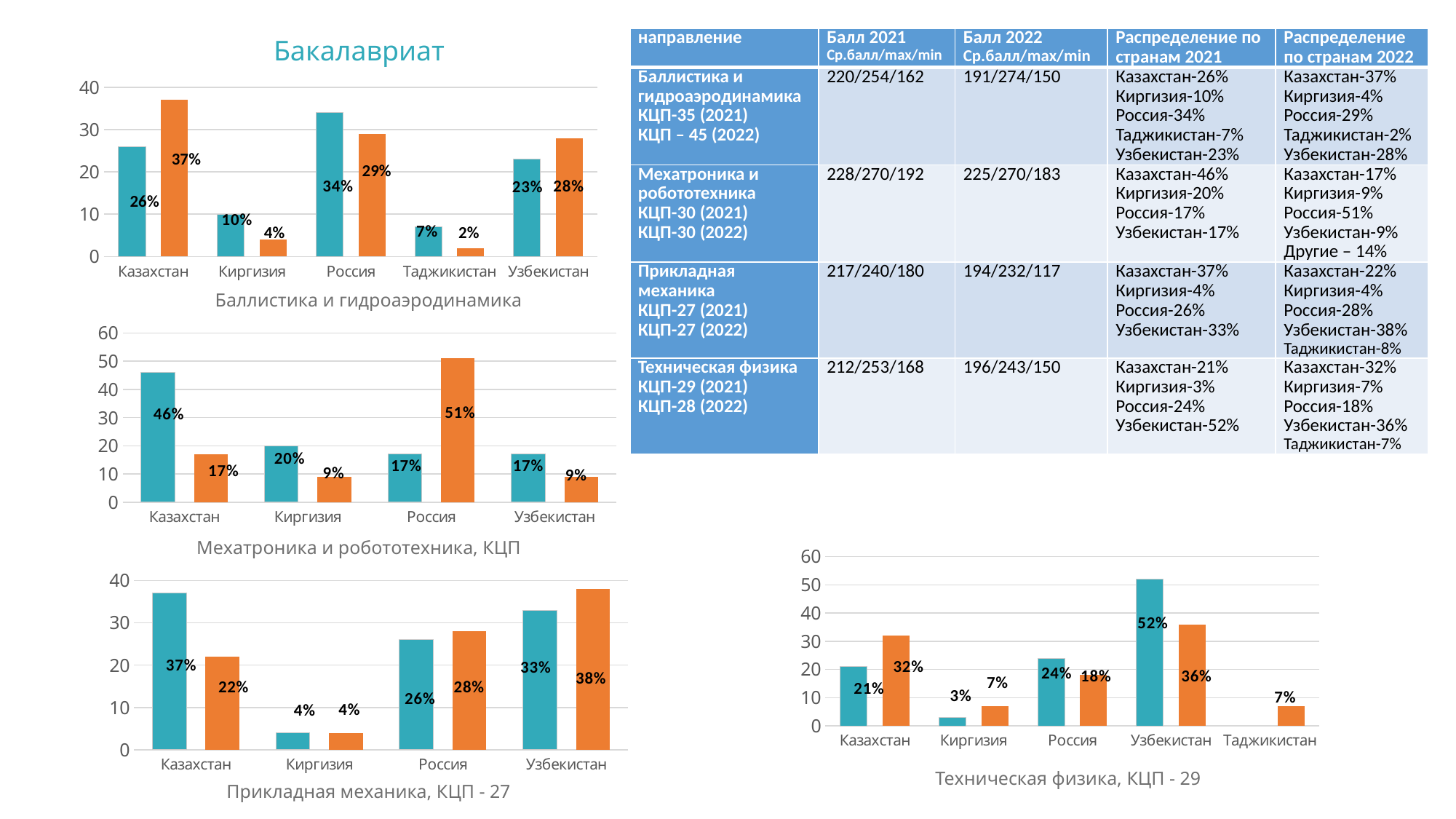
In the chart titled 'Баллистика и гидроаэродинамика', which category has the lowest orange bar? Таджикистан In the chart titled 'Мехатроника и робототехника, КЦП', which category has the highest teal bar? Казахстан In the chart titled 'Техническая физика, КЦП - 29', what is the value of the teal bar for Узбекистан? 52% In the chart titled 'Прикладная механика, КЦП - 27', what is the value of the teal bar for Узбекистан? 33% In the chart titled 'Баллистика и гидроаэродинамика', what is the value of the orange bar for Казахстан? 37% In the chart titled 'Баллистика и гидроаэродинамика', how many categories are shown on the x axis? 5 In the chart titled 'Прикладная механика, КЦП - 27', which is larger for Россия: the teal bar or the orange bar? the orange bar In the chart titled 'Техническая физика, КЦП - 29', what is the difference between the orange bar and the teal bar for Казахстан? 11% In the chart titled 'Прикладная механика, КЦП - 27', how many categories are shown on the x axis? 4 In the chart titled 'Мехатроника и робототехника, КЦП', what is the value of the orange bar for Россия? 51% What kind of chart is the one titled 'Техническая физика, КЦП - 29'? bar chart In the chart titled 'Мехатроника и робототехника, КЦП', what is the difference between the teal bar and the orange bar for Казахстан? 29%